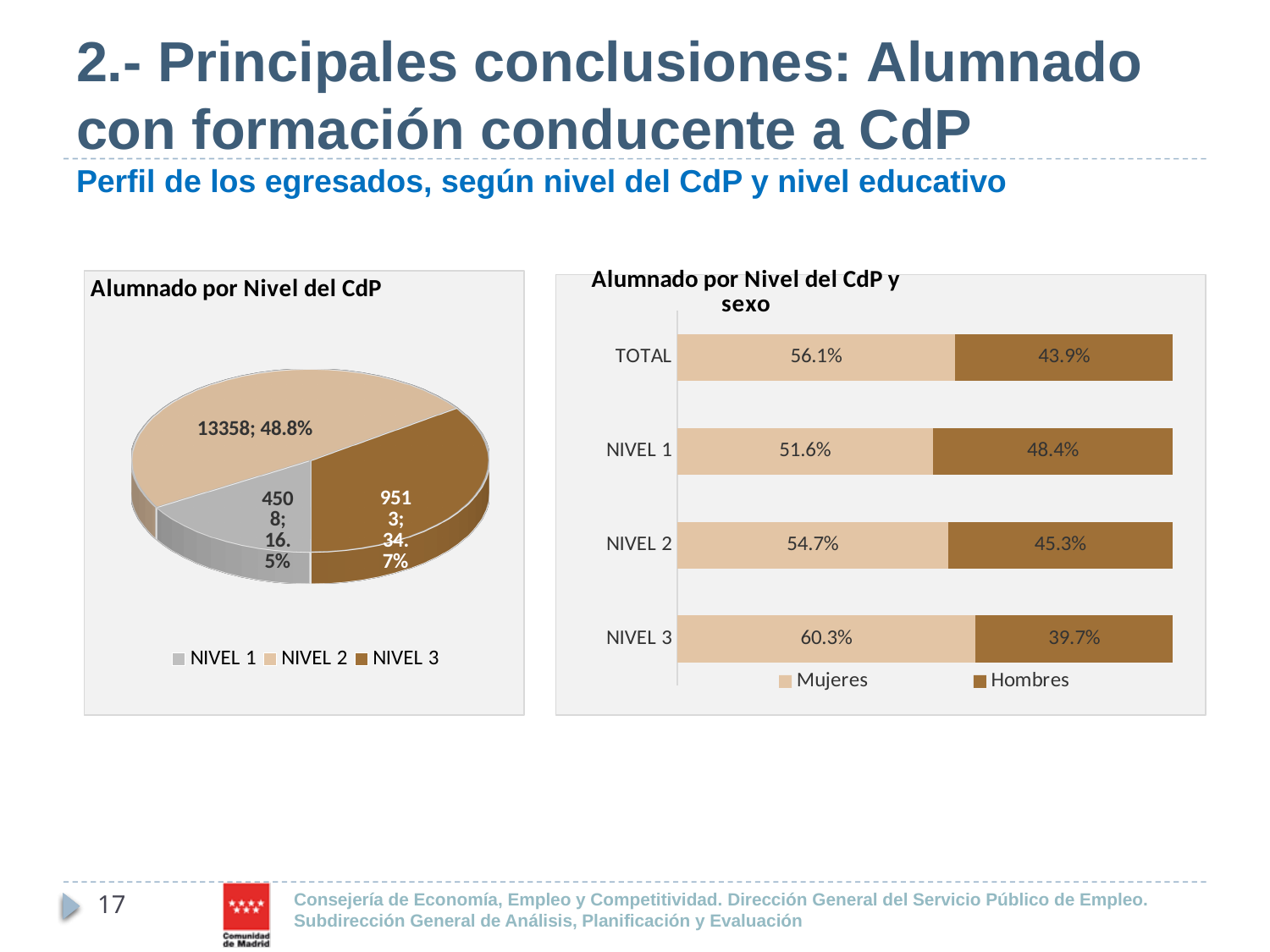
In the 'Alumnado por Nivel del CdP y sexo' chart, what is the difference between the Mujeres and Hombres values for NIVEL 1? 3.2% In the 'Alumnado por Nivel del CdP' pie chart, what percentage share does NIVEL 2 have? 48.8% In the 'Alumnado por Nivel del CdP y sexo' chart, what is the Mujeres value for NIVEL 3? 60.3% In the 'Alumnado por Nivel del CdP y sexo' chart, is the Hombres value for NIVEL 2 larger or smaller than the Hombres value for NIVEL 3? Larger What kind of chart is 'Alumnado por Nivel del CdP'? Pie chart What kind of chart is 'Alumnado por Nivel del CdP y sexo'? Stacked bar chart In the 'Alumnado por Nivel del CdP' pie chart, what is the number of students for NIVEL 2? 13358 In the 'Alumnado por Nivel del CdP y sexo' chart, what is the Hombres value for TOTAL? 43.9% How many series does the legend of the 'Alumnado por Nivel del CdP' pie chart list? 3 In the 'Alumnado por Nivel del CdP y sexo' chart, which level has the highest Mujeres percentage? NIVEL 3 In the 'Alumnado por Nivel del CdP' pie chart, which level has the smallest slice? NIVEL 1 In the 'Alumnado por Nivel del CdP' pie chart, which level has the largest slice? NIVEL 2